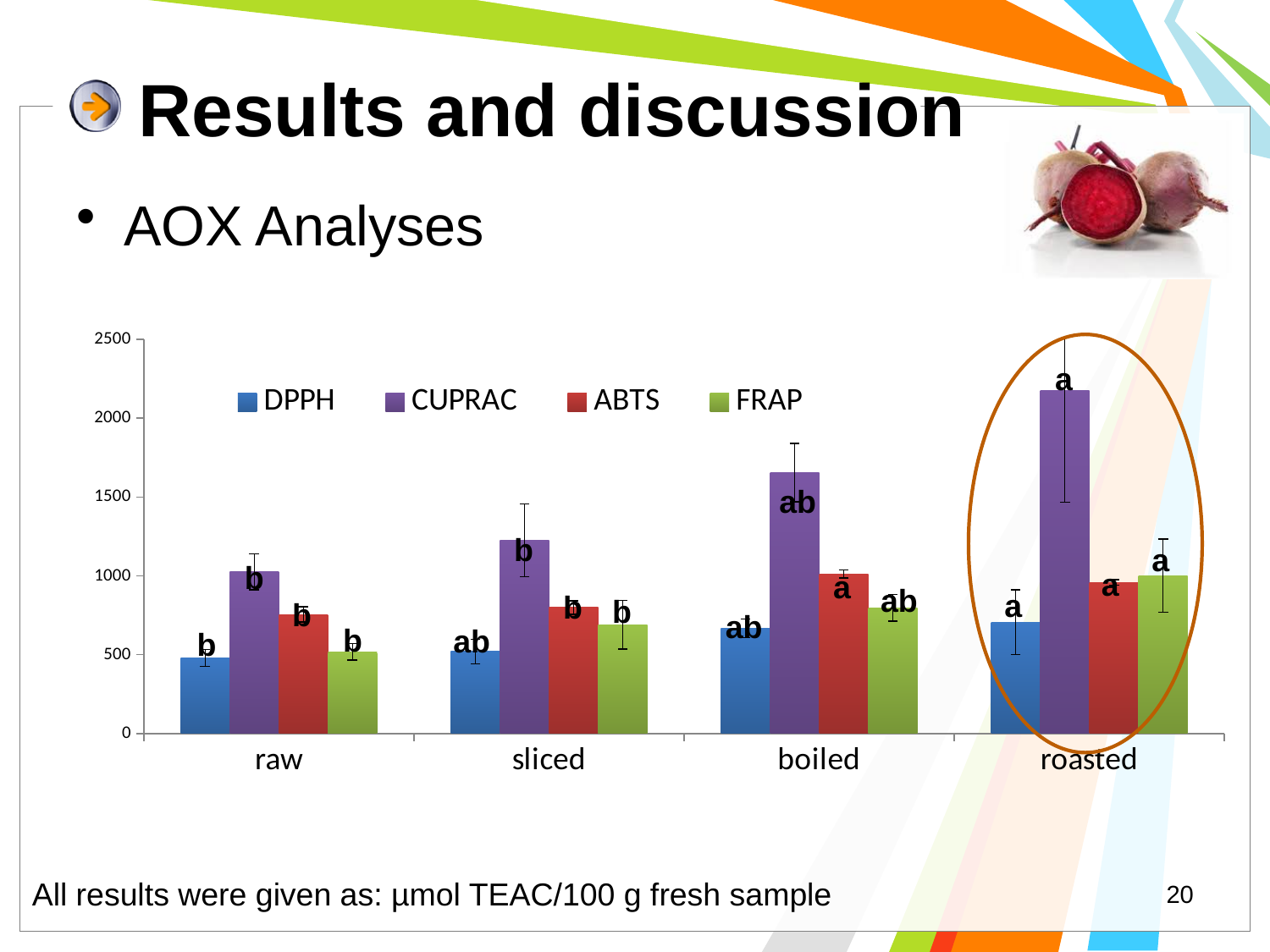
Which is larger, the CUPRAC value for boiled or the CUPRAC value for roasted? roasted Is the FRAP value for sliced greater or less than 1000? less Is the CUPRAC value for boiled greater or less than 1500? greater What are the four series listed in the legend? DPPH, CUPRAC, ABTS, FRAP Which series has the highest value in the roasted category? CUPRAC What kind of chart is shown on the slide? bar chart Which category has the highest CUPRAC value? roasted Is the CUPRAC value for roasted greater or less than 2000? greater How many series does the legend list? 4 How many categories are shown on the x axis? 4 Do the CUPRAC values rise or fall from raw to roasted along the x axis? rise Which series has the lowest value in the roasted category? DPPH